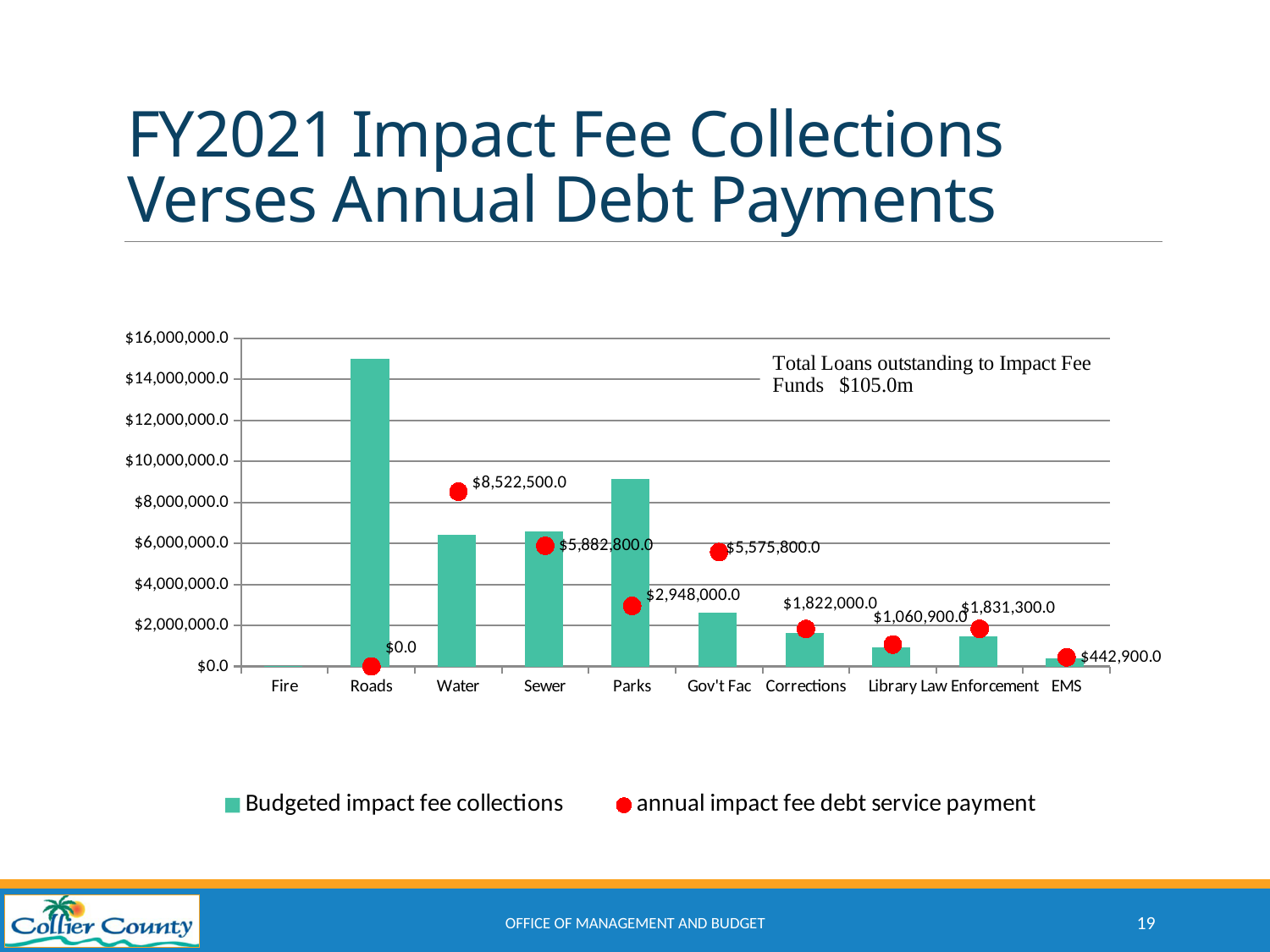
What is the annual impact fee debt service payment for Roads? $0.0 Which category has the highest annual impact fee debt service payment? Water What is the total of loans outstanding to Impact Fee Funds stated on the chart? $105.0m What is the annual impact fee debt service payment for Water? $8,522,500.0 What is the annual impact fee debt service payment for EMS? $442,900.0 How many series does the legend list? 2 What is the difference between the annual impact fee debt service payments for Sewer and Gov't Fac? $307,000.0 Which has the larger annual impact fee debt service payment, Corrections or Law Enforcement? Law Enforcement Which category has the highest budgeted impact fee collections? Roads What is the annual impact fee debt service payment for Sewer? $5,882,800.0 How many categories are shown on the x axis? 10 Is the budgeted impact fee collections value for Roads greater or less than $14,000,000.0? greater